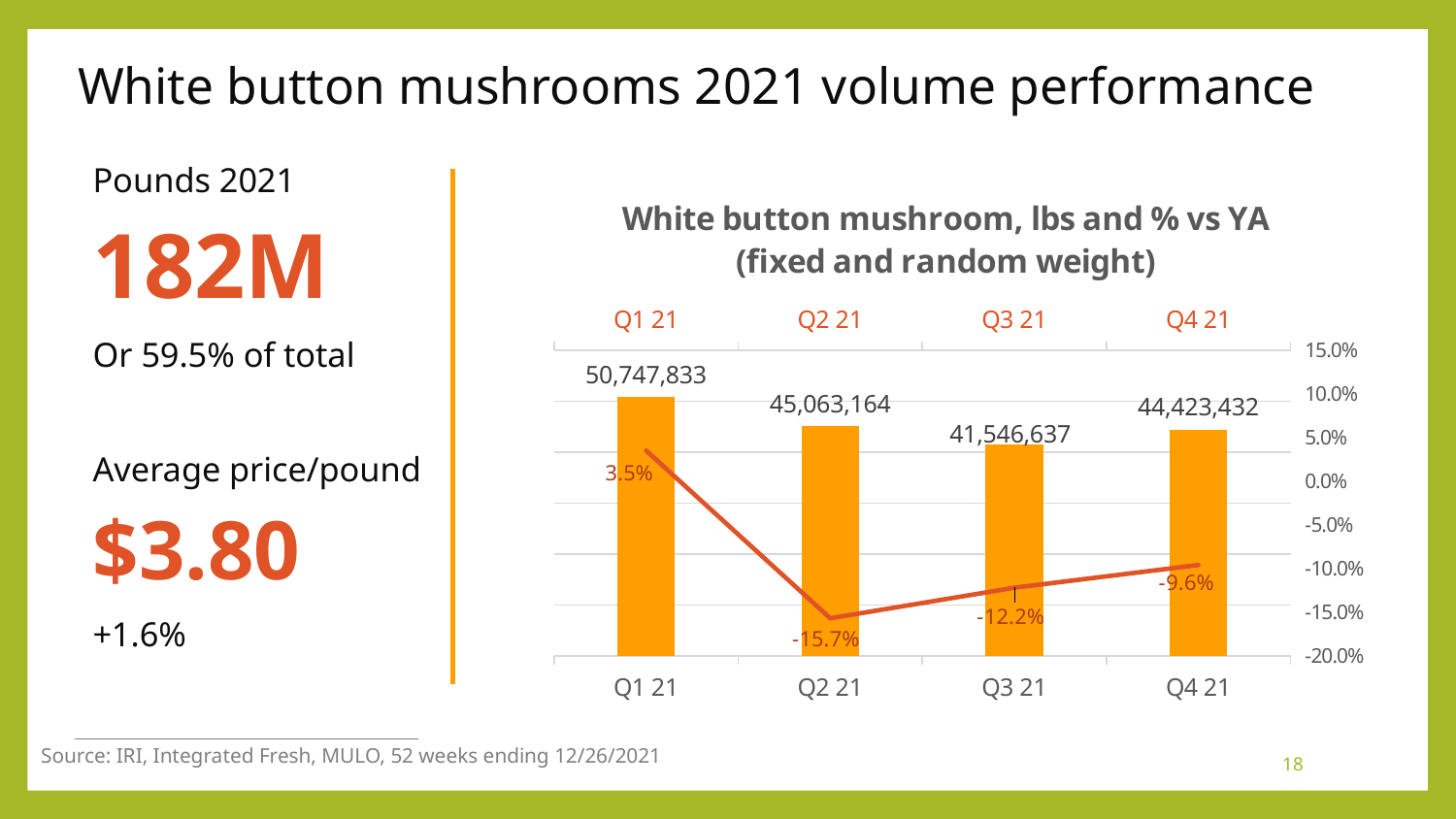
What is the volume in pounds for Q3 21? 41,546,637 Do the volumes in pounds rise or fall from Q1 21 to Q3 21? Fall What is the difference in pounds between Q1 21 and Q2 21? 5,684,669 What is the difference in pounds between Q4 21 and Q3 21? 2,876,795 Which quarter has the highest volume in pounds? Q1 21 Which quarter has the lowest % vs YA value? Q2 21 What is the % vs YA value for Q2 21? -15.7% What is the % vs YA value for Q4 21? -9.6% What kind of chart is this? Combination bar and line chart How many quarters are shown on the chart? 4 Which quarter has a larger volume in pounds, Q2 21 or Q4 21? Q2 21 What is the volume in pounds for Q1 21? 50,747,833